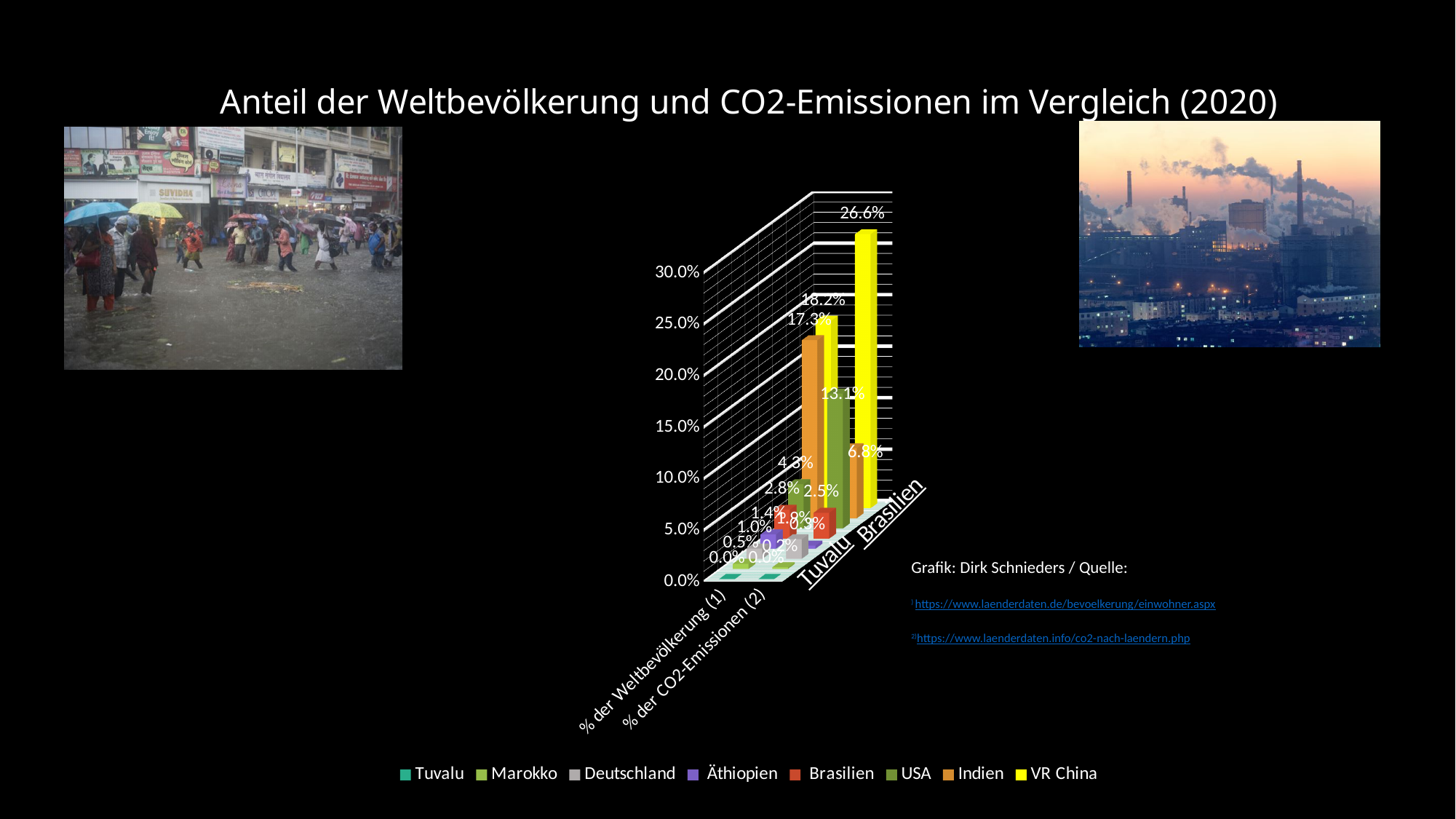
Which is larger for VR China: its share of world population or its share of CO2 emissions? share of CO2 emissions How many series does the chart legend list? 8 Is the value for VR China in '% der CO2-Emissionen (2)' greater or less than 25.0%? greater What is the title of the chart on the slide? Anteil der Weltbevölkerung und CO2-Emissionen im Vergleich (2020) What is the value for USA in the category '% der CO2-Emissionen (2)'? 13.1% How many categories are shown on the x axis of the chart? 2 What is the value for VR China in the category '% der CO2-Emissionen (2)'? 26.6% What is the value for VR China in the category '% der Weltbevölkerung (1)'? 18.2% What is the value for Indien in the category '% der Weltbevölkerung (1)'? 17.3% Which series has the highest value in the category '% der CO2-Emissionen (2)'? VR China What is the difference between VR China's share of CO2 emissions (26.6%) and its share of world population (18.2%)? 8.4% What kind of chart is shown on the slide? bar chart